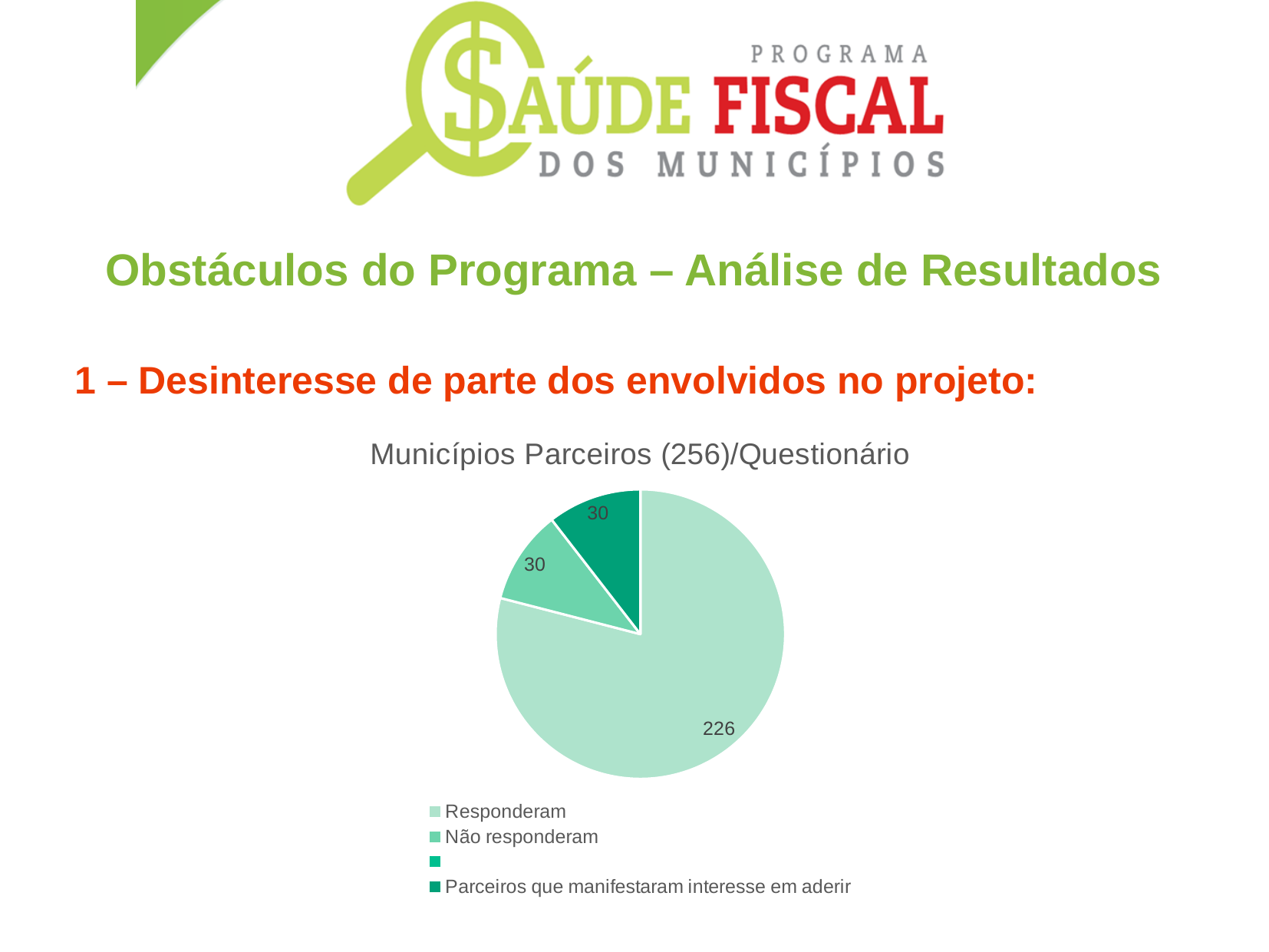
What is the value of the 'Não responderam' slice? 30 What is the difference between the 'Responderam' value and the 'Não responderam' value? 196 What is the value of the 'Responderam' slice? 226 What is the value of the 'Parceiros que manifestaram interesse em aderir' slice? 30 What kind of chart is shown on the slide? pie chart How many slices does the pie chart have? 3 Which category has the largest slice of the pie? Responderam Which is larger, 'Responderam' or 'Não responderam'? Responderam Which legend entry corresponds to the darkest green slice? Parceiros que manifestaram interesse em aderir What is the title of the chart? Municípios Parceiros (256)/Questionário